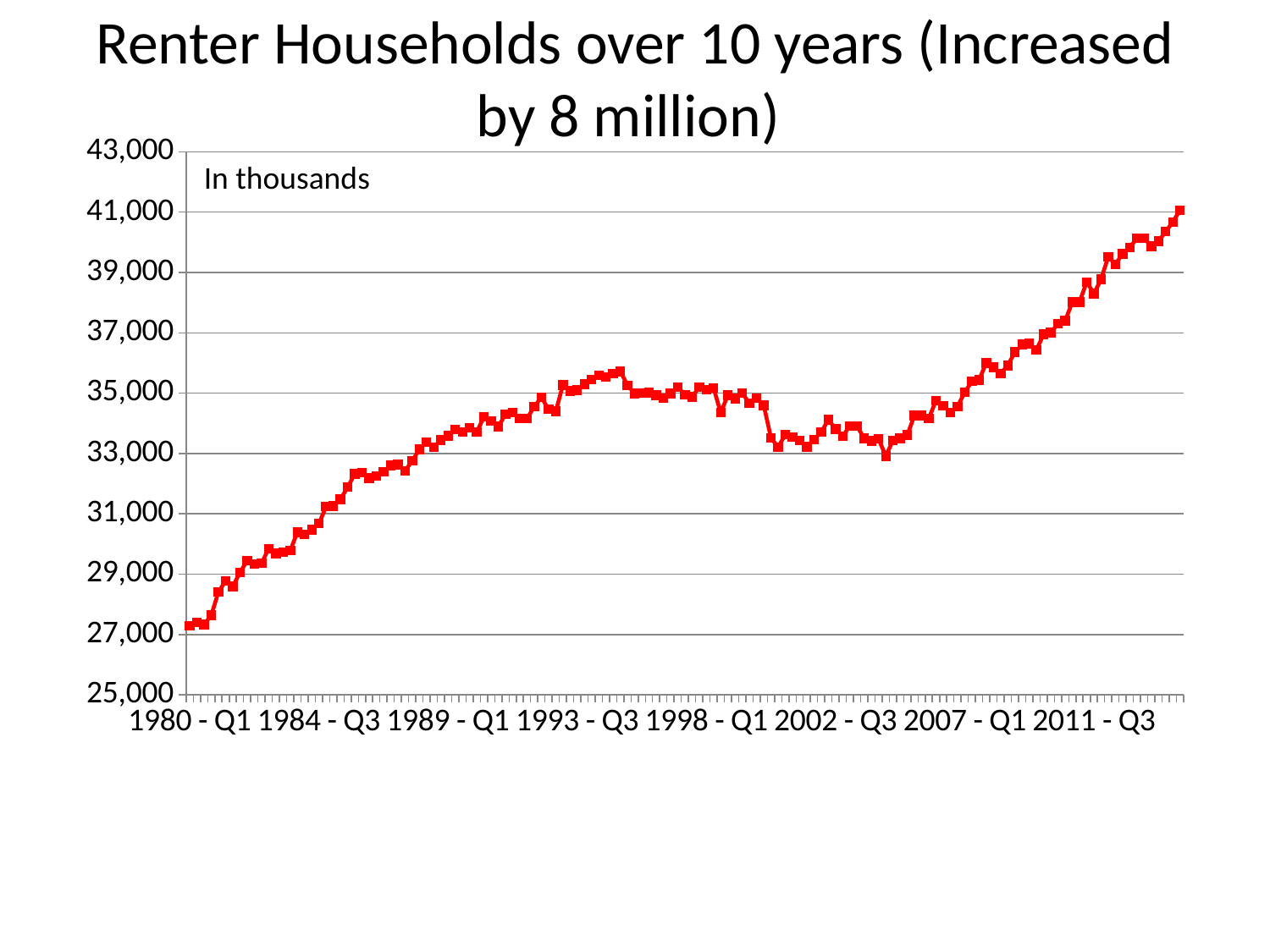
Is the value at 1984 - Q3 greater or less than 29,000? greater Between 2007 - Q1 and 2011 - Q3, do the values rise or fall? rise What is the title of the chart? Renter Households over 10 years (Increased by 8 million) Which is larger, the value at 1998 - Q1 or the value at 2011 - Q3? 2011 - Q3 Which of the labelled x-axis points has the lowest value? 1980 - Q1 What kind of chart is shown on the slide? line chart Is the value at 1993 - Q3 greater or less than 33,000? greater Overall, do the values rise or fall from 1980 - Q1 to the end of the series? rise Is the value at 1980 - Q1 greater or less than 29,000? less Between 1998 - Q1 and 2002 - Q3, do the values generally rise or fall? fall In what units are the values on the chart expressed, according to the note inside the plot area? In thousands